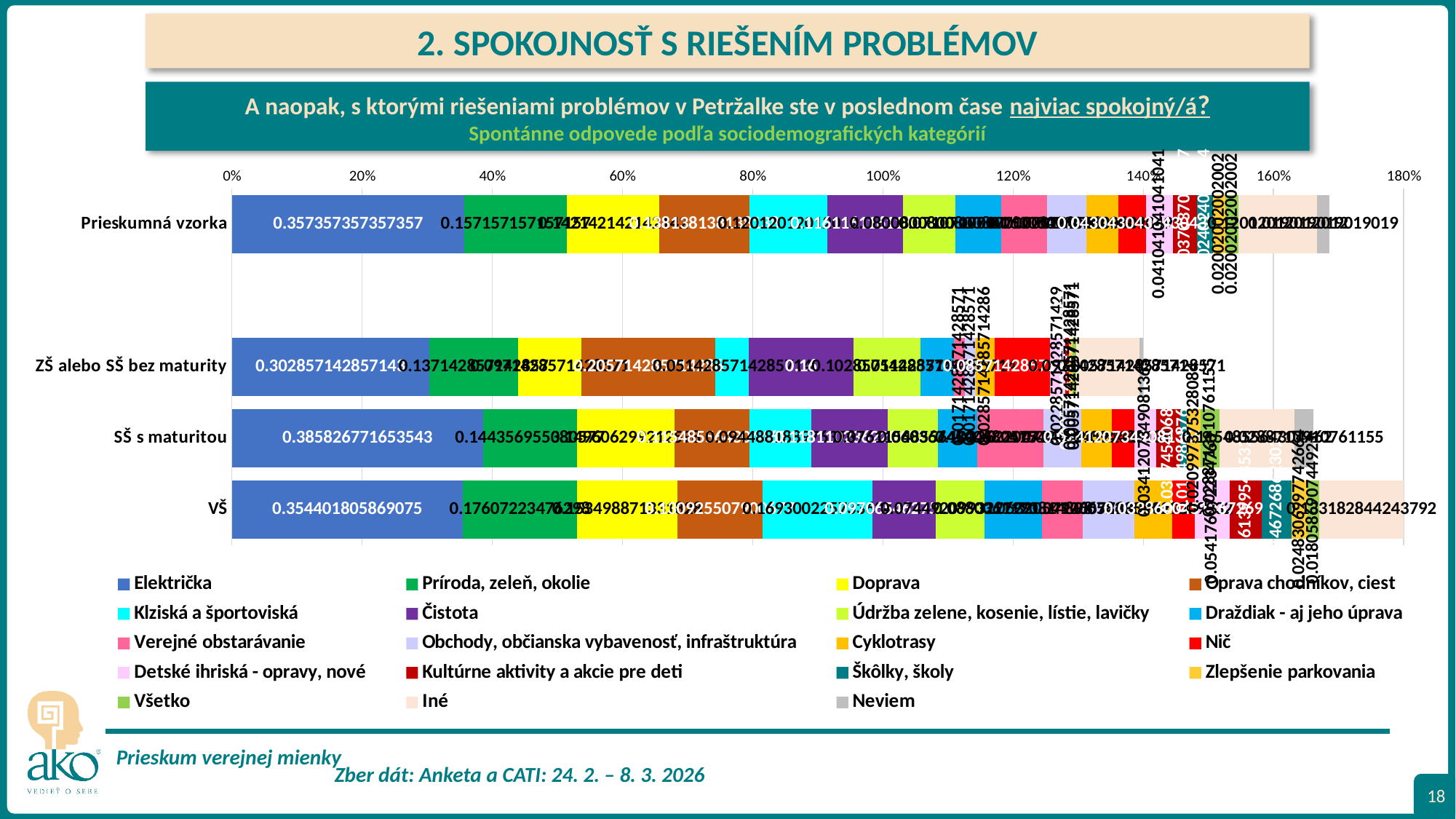
What is the Električka value for SŠ s maturitou? 0.385826771653543 What is the Električka value for Prieskumná vzorka? 0.357357357357357 How many series does the legend list? 19 How many categories (rows) does the chart show? 4 Which legend entry is shown in red? Nič Which category has the highest Električka value? SŠ s maturitou What is the Električka value for VŠ? 0.354401805869075 Which has the larger Električka value, VŠ or ZŠ alebo SŠ bez maturity? VŠ Which category has the lowest Električka value? ZŠ alebo SŠ bez maturity What kind of chart is shown on the slide? stacked bar chart What is the Električka value for ZŠ alebo SŠ bez maturity? 0.302857142857143 Is the Električka segment for VŠ greater or less than 40% on the axis? less